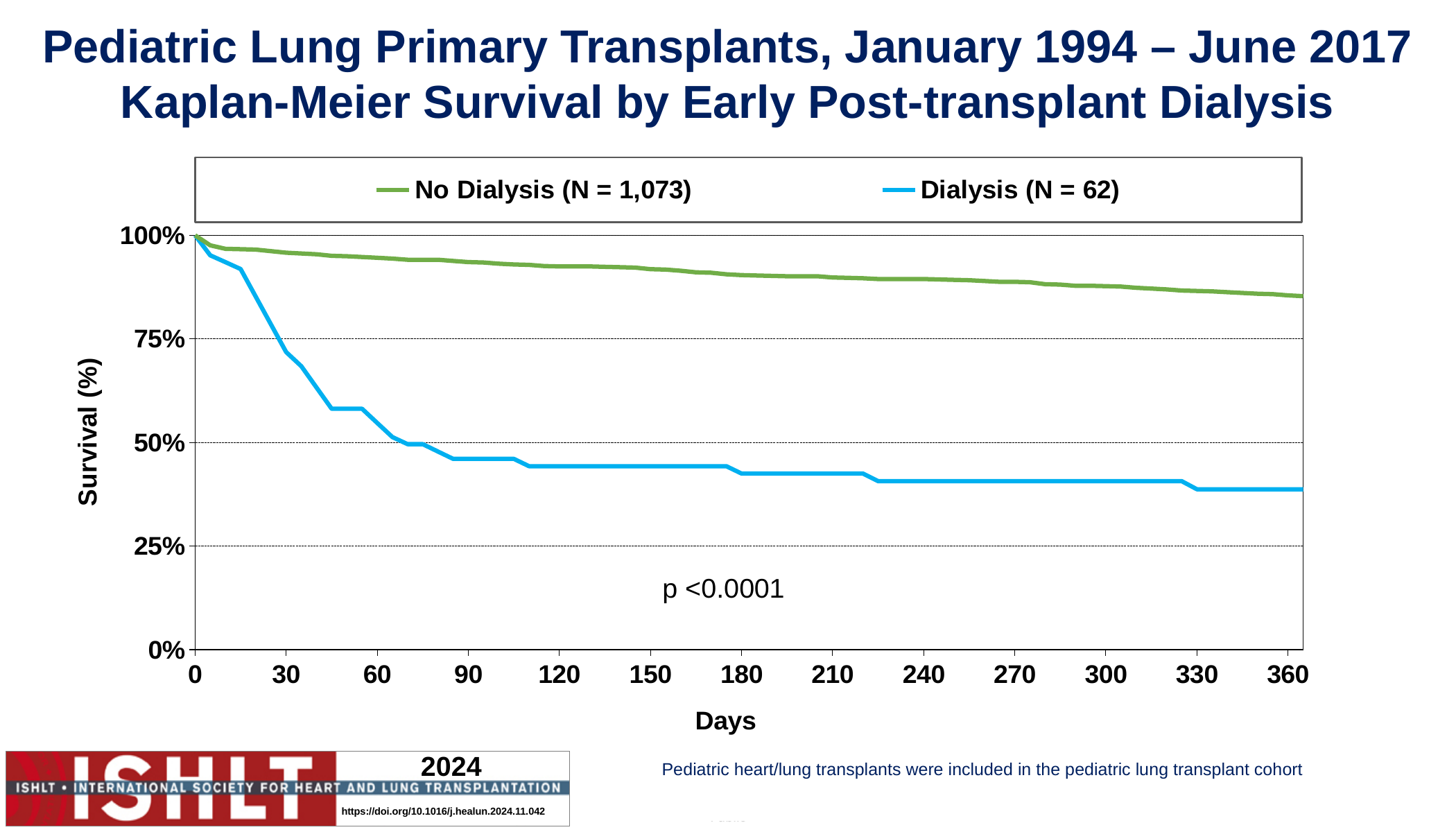
How many series does the legend list? 2 Is the survival value for the No Dialysis group at day 180 greater or less than 75%? greater What p-value is printed on the chart? p <0.0001 Does survival for the Dialysis group rise or fall as days increase? fall Is the survival value for the Dialysis group at day 360 greater or less than 50%? less Which group has the higher survival at day 360, No Dialysis or Dialysis? No Dialysis What is the survival value for the Dialysis group at day 0? 100% What is the N for the No Dialysis group shown in the legend? 1,073 Is the survival value for the No Dialysis group at day 360 greater or less than 75%? greater What kind of chart is shown on the slide? line chart